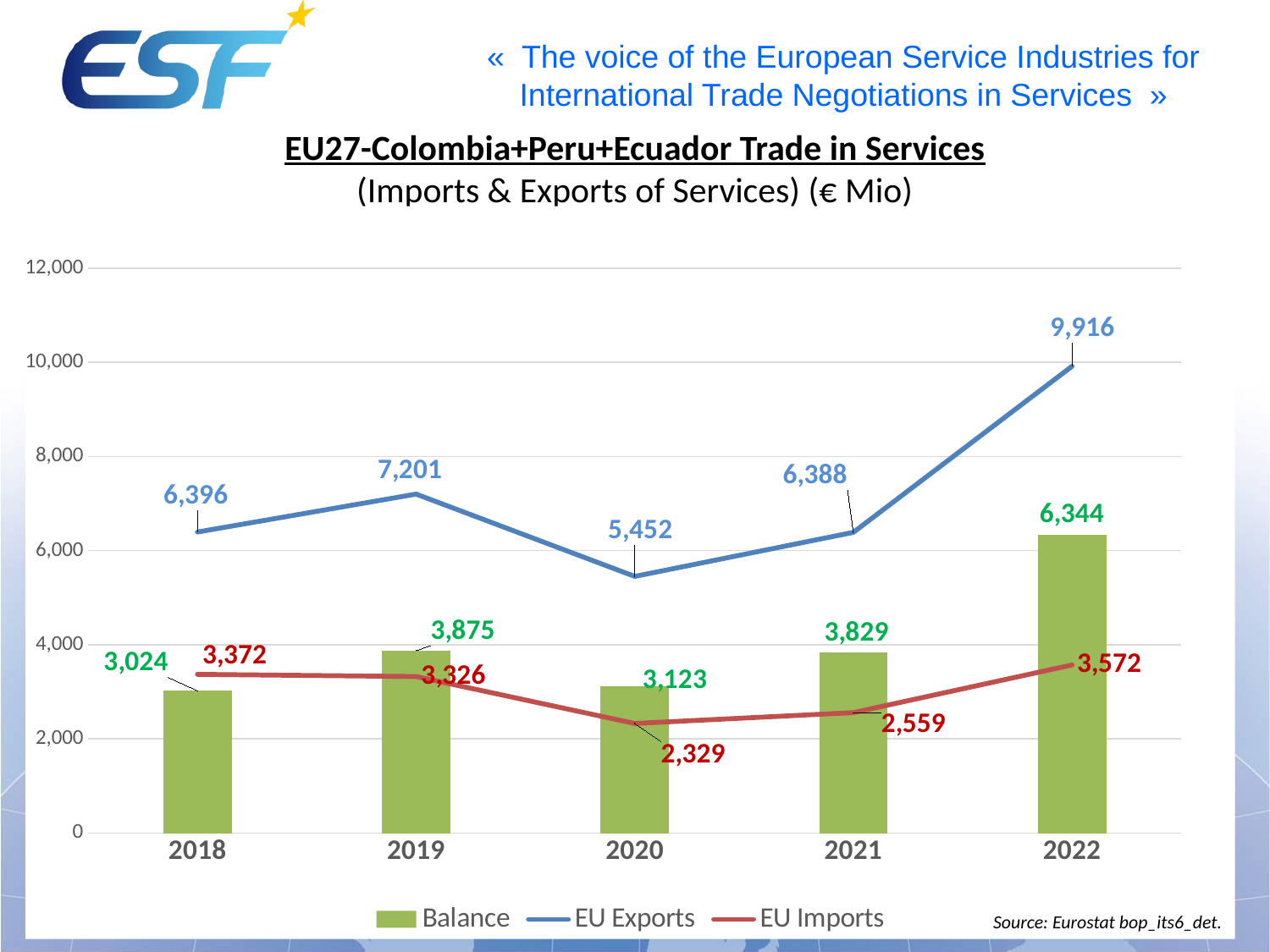
What is the difference between EU Exports and EU Imports in 2021? 3,829 What is the value of EU Exports in 2022? 9,916 What is the Balance value for 2019? 3,875 Is the value of EU Exports in 2019 greater or less than 8,000? less In which year is EU Exports lowest? 2020 How many series does the legend list? 3 Do EU Exports rise or fall from 2021 to 2022? rise Which is larger: EU Imports in 2018 or EU Imports in 2022? EU Imports in 2022 Which series is shown as bars rather than lines? Balance In which year is the Balance highest? 2022 How many years are shown on the x axis? 5 What is the value of EU Imports in 2020? 2,329